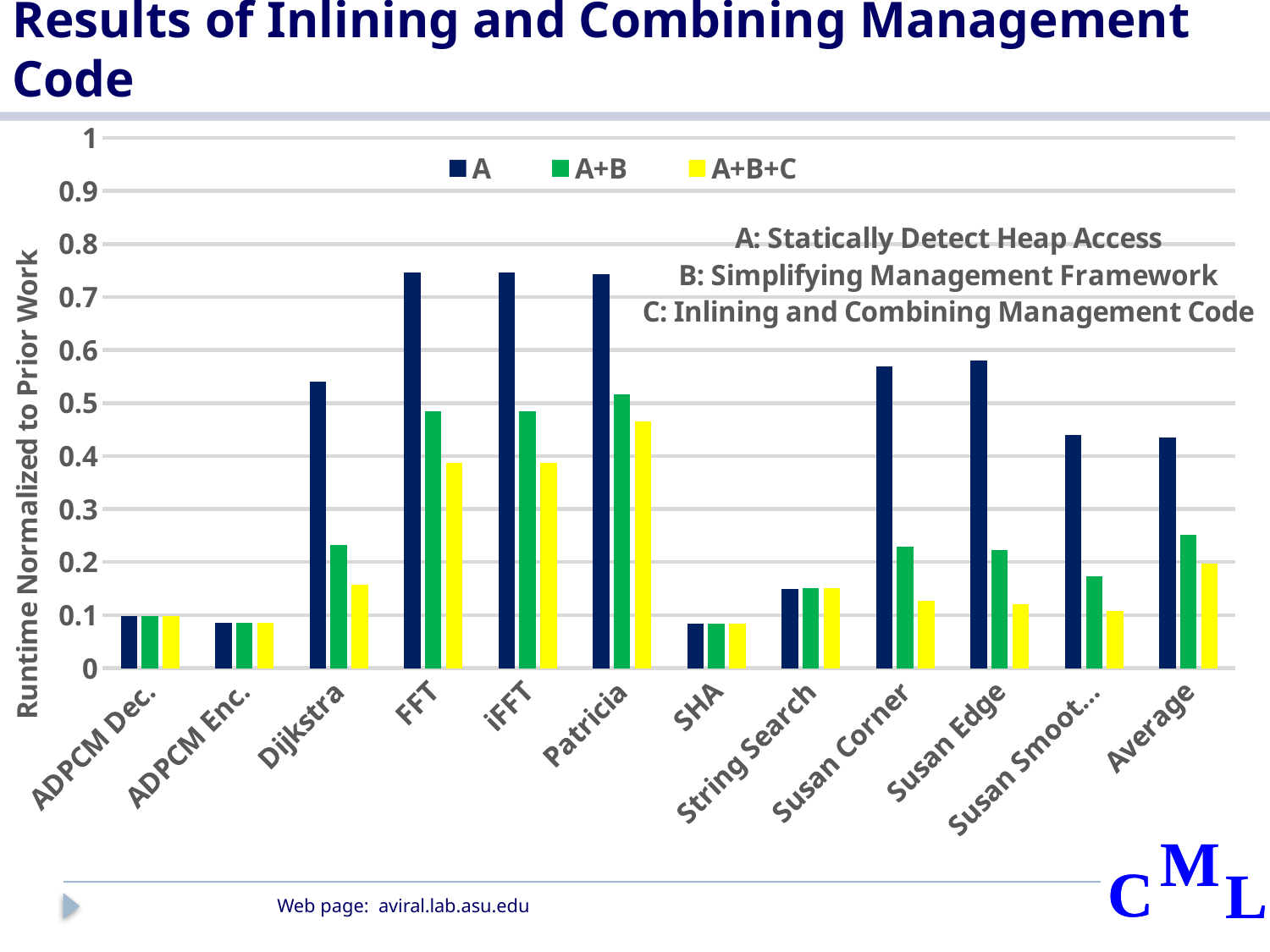
Which category has the highest value for series A+B+C? Patricia Is the value of series A for Dijkstra greater or less than 0.5? greater What is the title of the y axis? Runtime Normalized to Prior Work Is the value of series A+B for Average greater or less than 0.2? greater What kind of chart is shown on the slide? bar chart Is the value of series A for Average greater or less than 0.4? greater Which is larger: the series A value for FFT or the series A value for Average? FFT How many series does the legend list? 3 How many benchmark categories are shown along the x axis? 12 Which is larger: the series A+B value for Dijkstra or the series A+B value for Susan Smoot...? Dijkstra